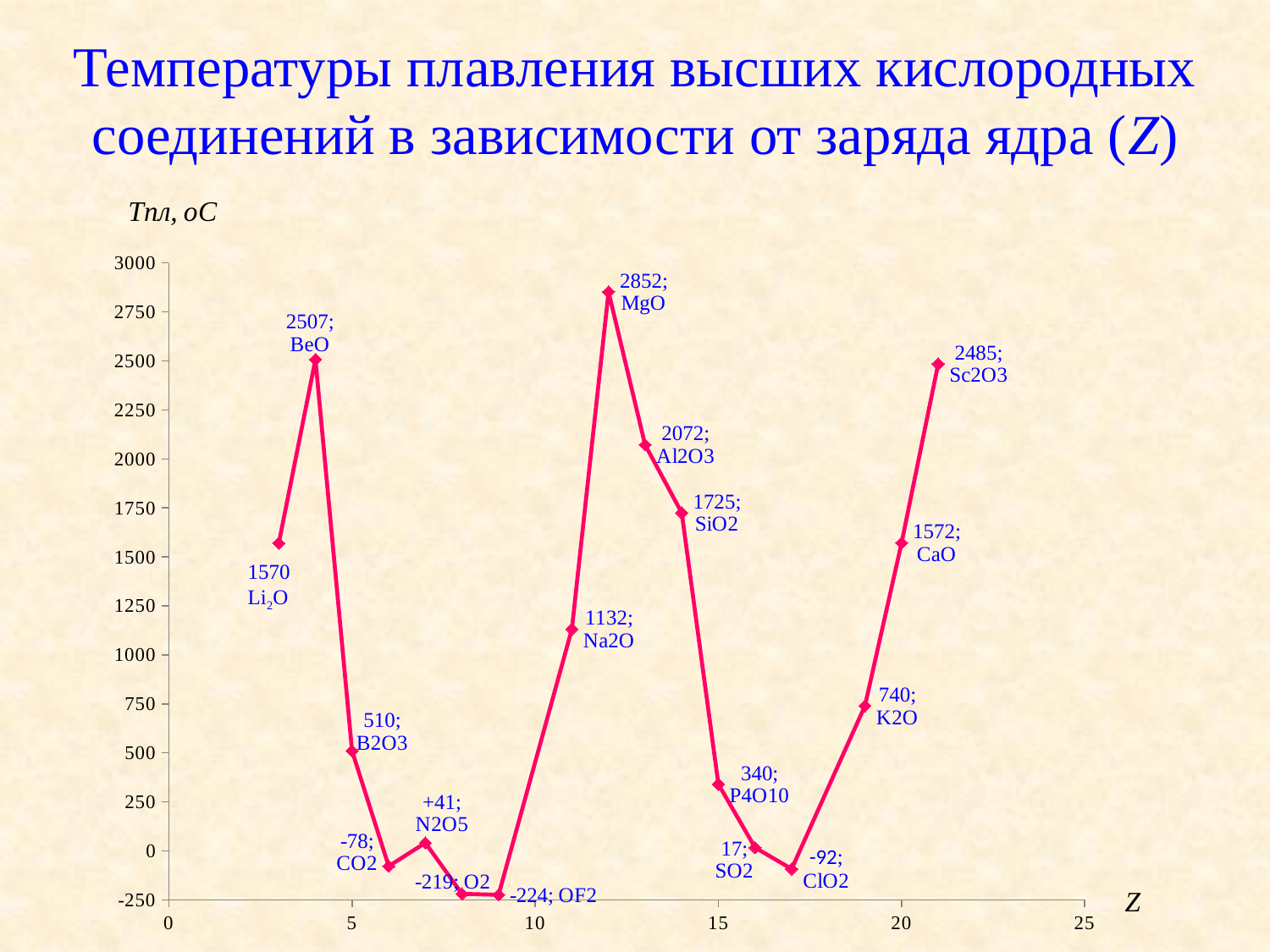
How many data points are plotted on the chart? 17 What is the melting point value shown for BeO? 2507 What value is labelled for K2O? 740 Which has a higher melting point, BeO or Sc2O3? BeO What is the difference between the melting points of Sc2O3 and CaO? 913 Which compound has the lowest melting point on the chart? OF2 What type of chart is shown on the slide? line chart Which has a higher melting point, Na2O or SiO2? SiO2 Which compound has the highest melting point on the chart? MgO What value is labelled for OF2? -224 What is the melting point value shown for MgO? 2852 What is the difference between the melting points of MgO and Al2O3? 780